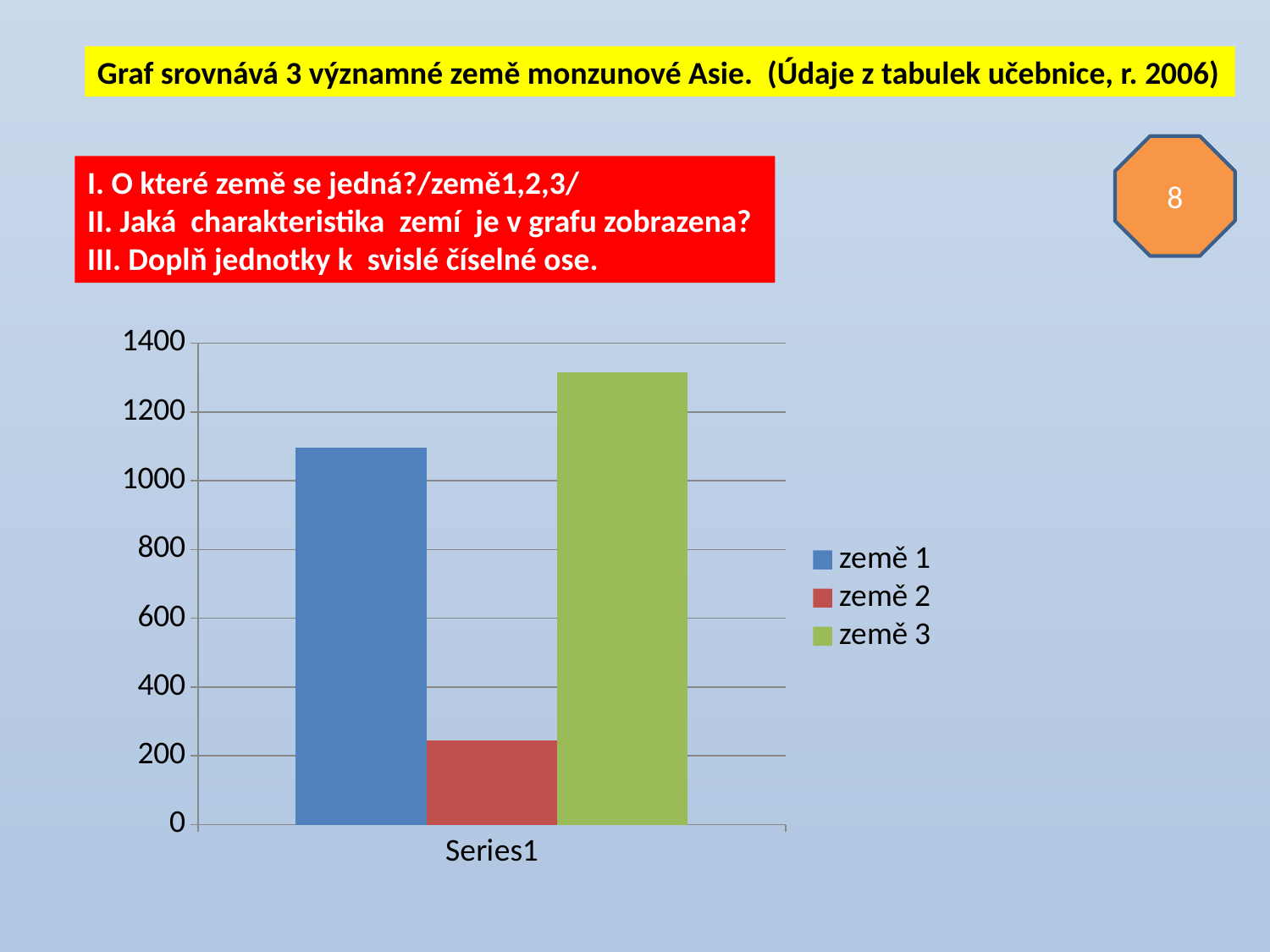
Which is larger, the value for země 1 or the value for země 2? země 1 Is the value for země 2 greater or less than 400? less Which is larger, the value for země 3 or the value for země 1? země 3 What is the label of the category on the x axis? Series1 Which series has the highest bar? země 3 Is the value for země 1 greater or less than 1200? less Is the value for země 3 greater or less than 1200? greater What kind of chart is shown on the slide? bar chart How many categories are shown on the x axis? 1 How many series does the legend list? 3 Which series has the lowest bar? země 2